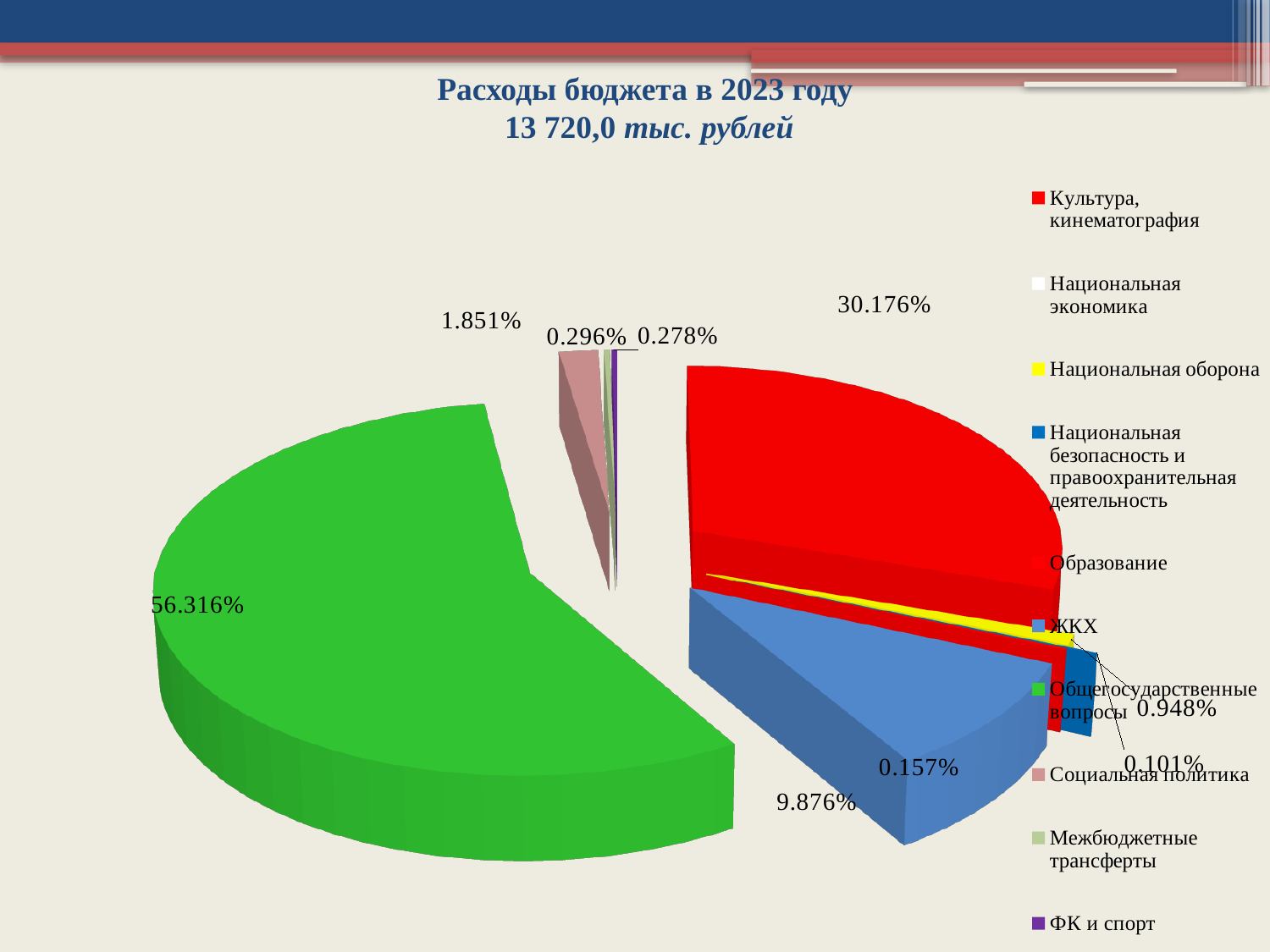
What kind of chart is shown on the slide? pie chart What share of the budget expenditure goes to Социальная политика? 1.851% Is the share for Образование greater or less than 50%? less Which has the larger share: Культура, кинематография or ЖКХ? Культура, кинематография What share of the budget expenditure goes to ЖКХ? 9.876% What share of the budget expenditure goes to Образование? 0.157% What share of the budget expenditure goes to Культура, кинематография? 30.176% Which category has the largest share of the pie? Общегосударственные вопросы What is the title of the chart? Расходы бюджета в 2023 году 13 720,0 тыс. рублей How many categories are listed in the legend? 10